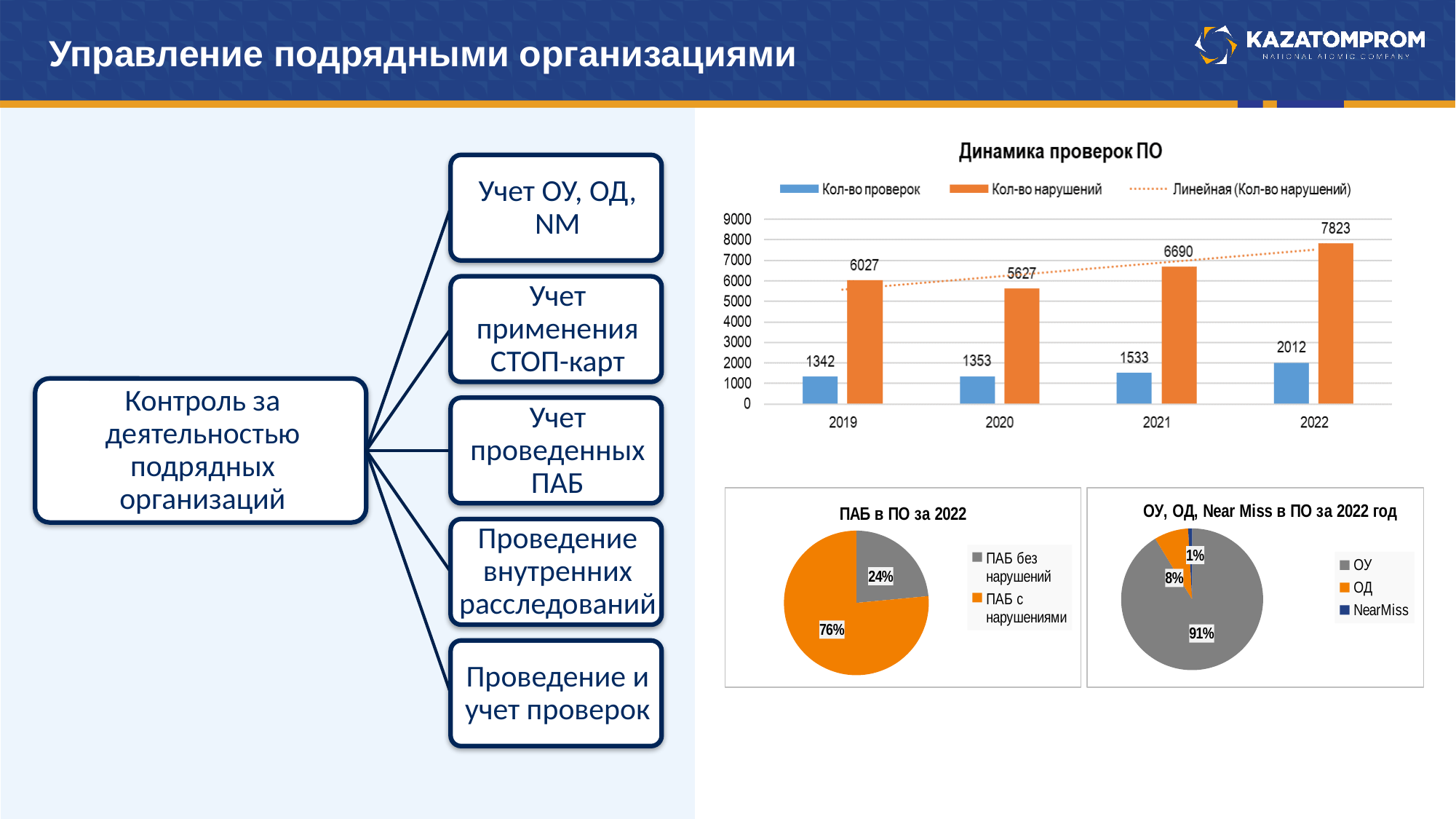
What kind of chart is 'Динамика проверок ПО'? Bar chart In the chart 'Динамика проверок ПО', what is the difference between 'Кол-во проверок' in 2022 and in 2021? 479 In the chart 'Динамика проверок ПО', do the values of 'Кол-во проверок' rise or fall from 2019 to 2022? Rise In the chart 'Динамика проверок ПО', is 'Кол-во нарушений' larger in 2019 or in 2020? 2019 In the chart 'Динамика проверок ПО', how many years are shown on the x axis? 4 In the pie chart 'ОУ, ОД, Near Miss в ПО за 2022 год', what share is 'ОД'? 8% In the chart 'Динамика проверок ПО', which year has the highest 'Кол-во нарушений'? 2022 In the chart 'Динамика проверок ПО', how many entries does the legend list? 3 In the chart 'Динамика проверок ПО', which year has the lowest 'Кол-во нарушений'? 2020 In the chart 'Динамика проверок ПО', what is the value of 'Кол-во нарушений' for 2022? 7823 In the chart 'Динамика проверок ПО', what is the value of 'Кол-во проверок' for 2019? 1342 In the pie chart 'ПАБ в ПО за 2022', what share is 'ПАБ с нарушениями'? 76%